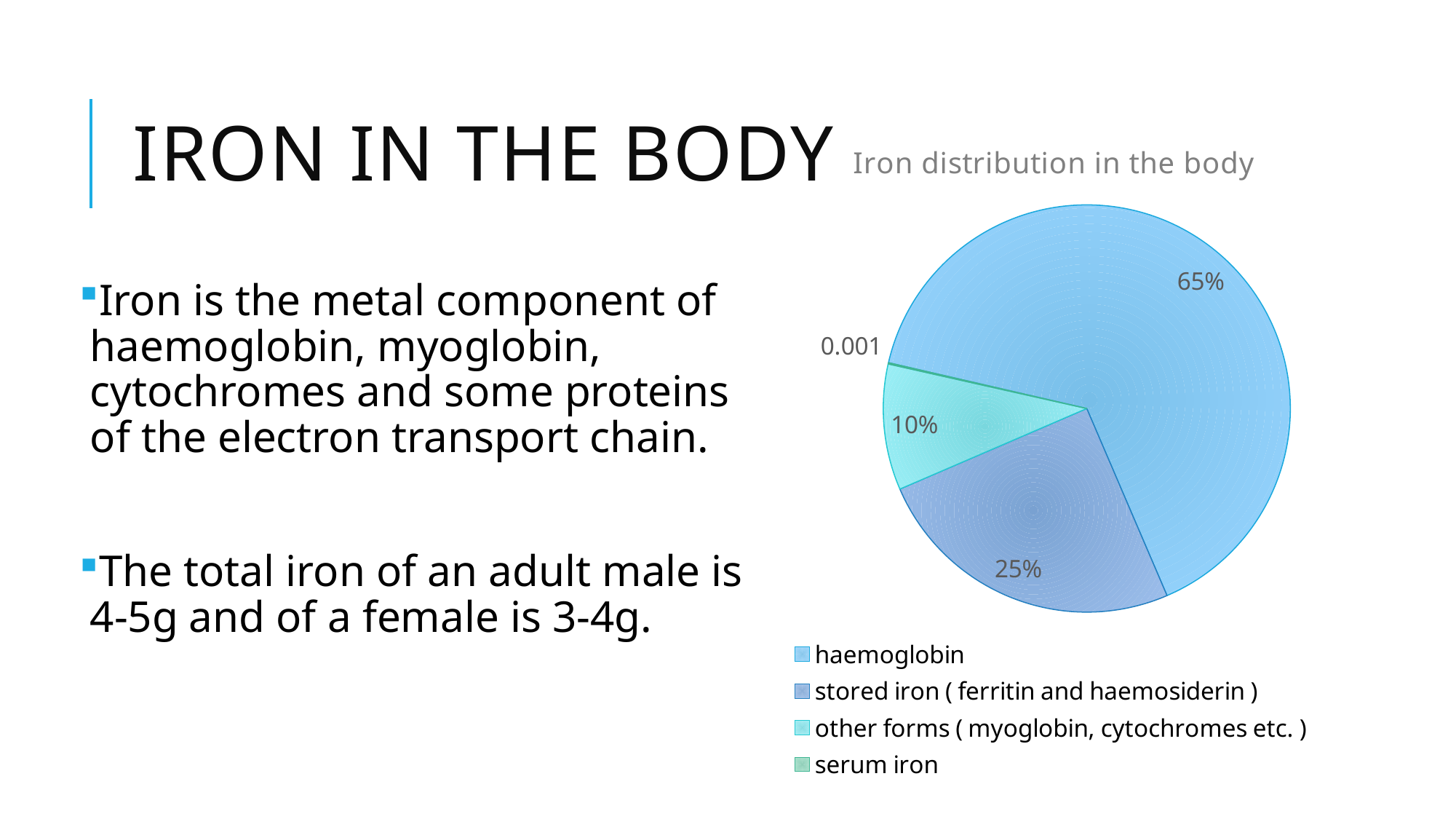
What is the title of the chart? Iron distribution in the body How many categories does the legend list? 4 What value is shown for other forms ( myoglobin, cytochromes etc. )? 10% What is the difference between the haemoglobin share and the stored iron share? 40% Which is larger, the slice for haemoglobin or the slice for stored iron ( ferritin and haemosiderin )? haemoglobin What value is shown for stored iron ( ferritin and haemosiderin )? 25% Which category has the largest slice of the pie? haemoglobin Which category has the smallest slice of the pie? serum iron What share of the pie is labelled for haemoglobin? 65% What kind of chart is shown on the slide? pie chart What is the difference between the stored iron share and the other forms share? 15% What value is shown for serum iron? 0.001